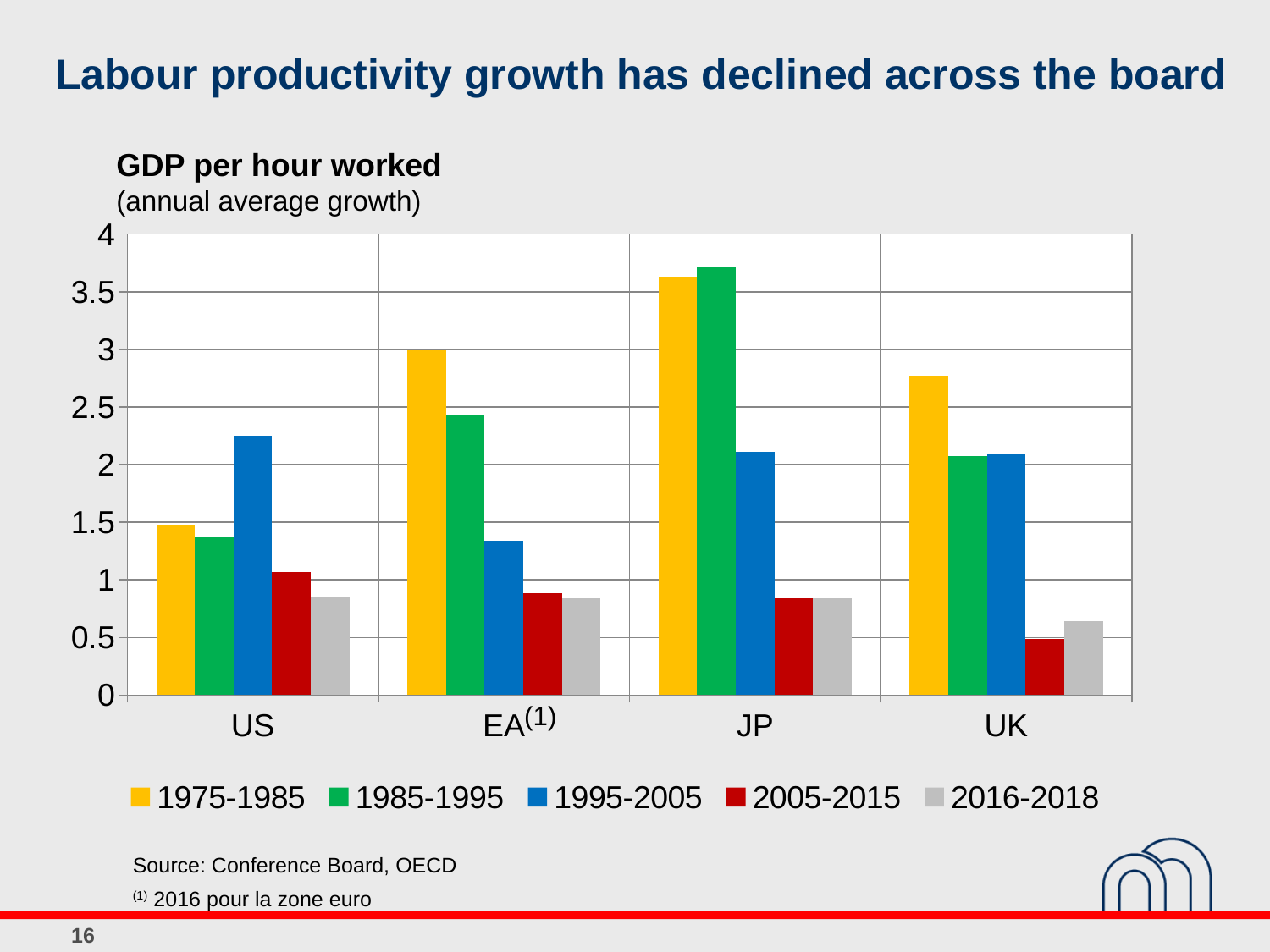
What is the title of the chart? GDP per hour worked For EA, do the values rise or fall from 1975-1985 through to 2016-2018? fall Which country/region has the highest value for 1975-1985? JP What kind of chart is shown on the slide? bar chart How many series does the legend list? 5 Which is larger for 1975-1985: the value for JP or the value for UK? JP Is the value for JP in 1985-1995 greater or less than 3.5? greater Is the value for US in 1995-2005 greater or less than 2? greater Which country/region has the lowest value for 2005-2015? UK Which is larger for 1985-1995: the value for EA or the value for US? EA How many countries/regions are shown on the x axis? 4 Is the value for UK in 2005-2015 greater or less than 1? less